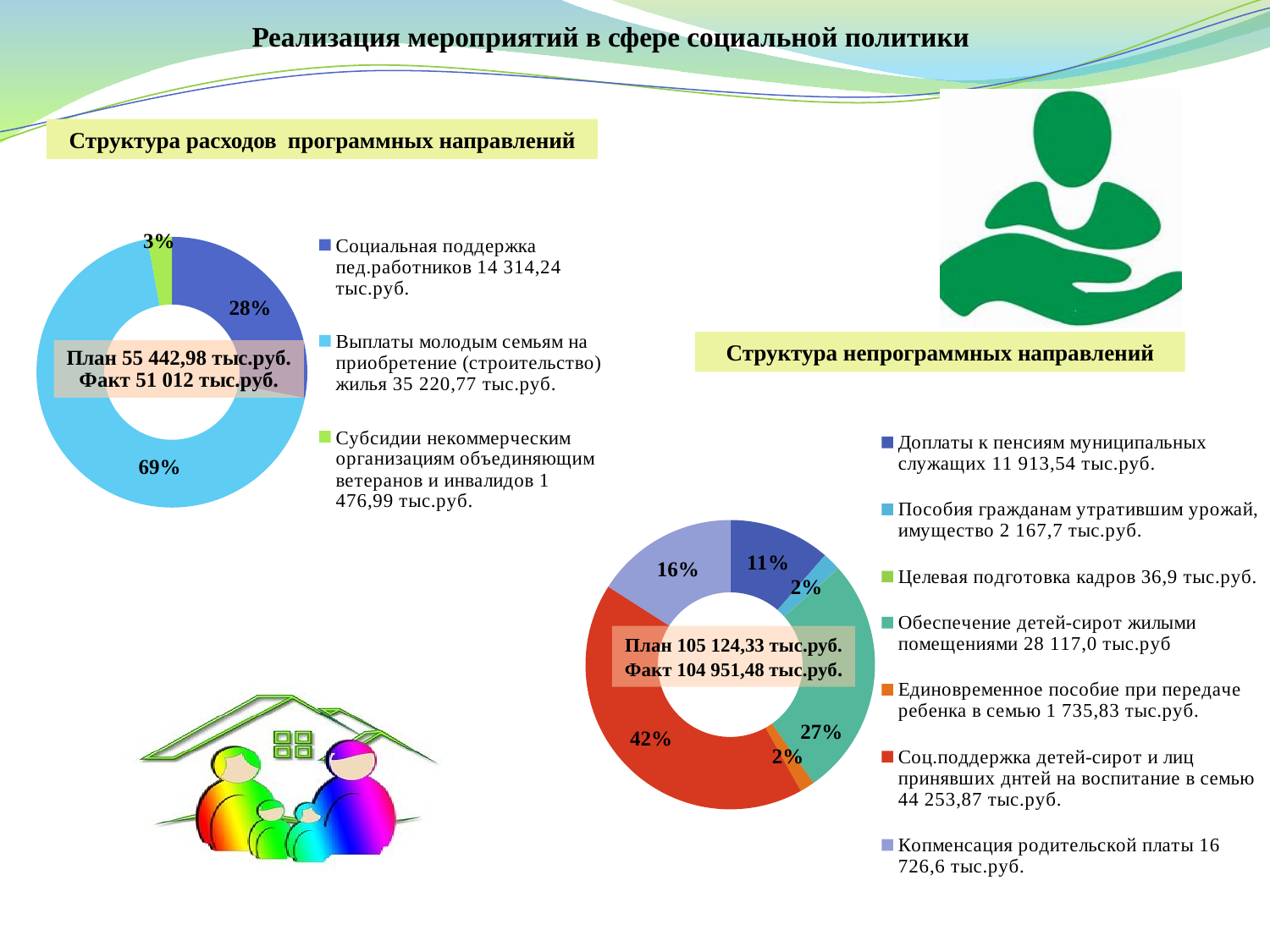
How many categories does the legend of the 'Структура расходов программных направлений' chart list? 3 What fact value is printed in the centre of the 'Структура непрограммных направлений' chart? Факт 104 951,48 тыс.руб. In the 'Структура непрограммных направлений' chart, which category has the largest share? Соц.поддержка детей-сирот и лиц принявших детей на воспитание в семью In the 'Структура непрограммных направлений' chart, what share is shown for 'Соц.поддержка детей-сирот и лиц принявших детей на воспитание в семью'? 42% In the 'Структура непрограммных направлений' chart, what is the difference in percentage points between the 42% slice and the 16% slice? 26 percentage points In the 'Структура расходов программных направлений' chart, what share is shown for 'Выплаты молодым семьям на приобретение (строительство) жилья'? 69% In the 'Структура расходов программных направлений' chart, which category has the smallest share? Субсидии некоммерческим организациям объединяющим ветеранов и инвалидов In the 'Структура непрограммных направлений' chart, what share is shown for 'Обеспечение детей-сирот жилыми помещениями'? 27% How many categories does the legend of the 'Структура непрограммных направлений' chart list? 7 What kind of chart is used in the 'Структура расходов программных направлений' chart? Doughnut (pie) chart What plan value is printed in the centre of the 'Структура расходов программных направлений' chart? План 55 442,98 тыс.руб.